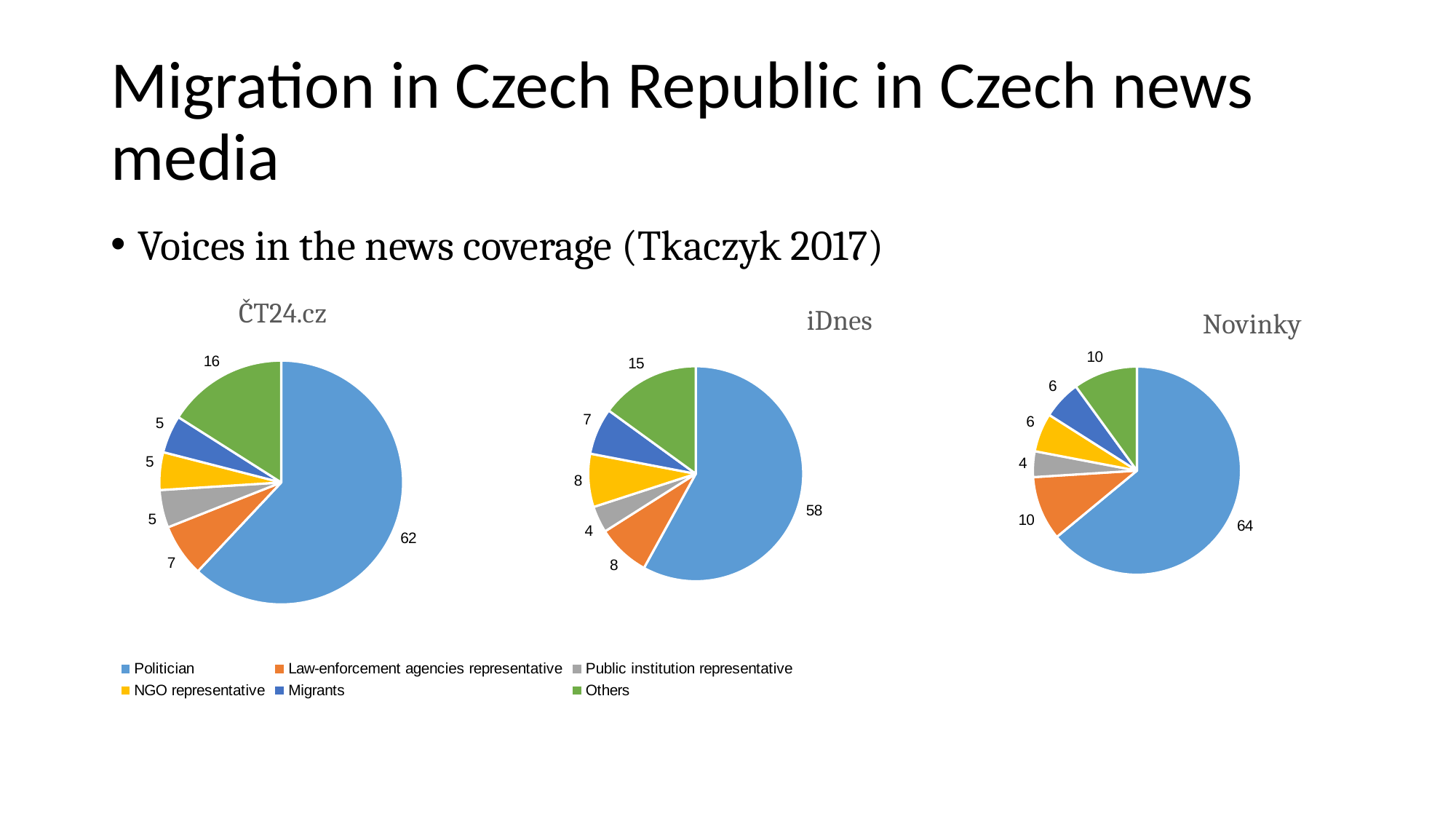
In the ČT24.cz chart, what is the value for Politician? 62 How many entries does the legend list? 6 Which is larger: the Politician value in the Novinky chart or the Politician value in the iDnes chart? Novinky In the Novinky chart, which category has the largest slice? Politician In the iDnes chart, what is the value for Migrants? 7 In the Novinky chart, what is the value for Law-enforcement agencies representative? 10 What kind of chart is the iDnes chart? Pie chart In the iDnes chart, what is the value for Others? 15 How many slices does the ČT24.cz pie chart have? 6 In the iDnes chart, which category has the smallest slice? Public institution representative Which colour represents Migrants in the legend? Dark blue In the ČT24.cz chart, what is the difference between the values for Politician and Others? 46